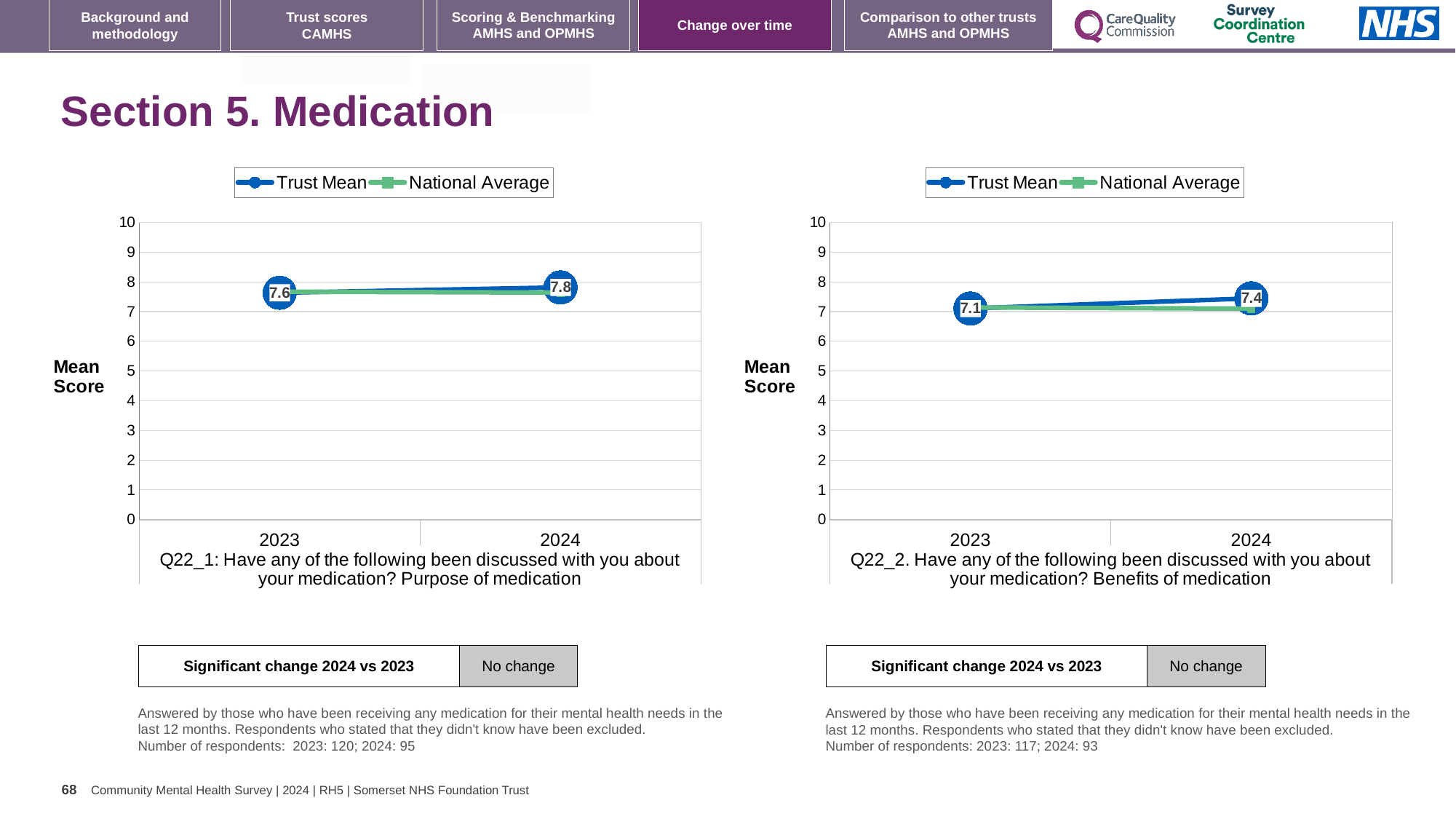
On the left chart (Q22_1: Purpose of medication), what is the Trust Mean for 2024? 7.8 On the right chart (Q22_2: Benefits of medication), what is the difference between the Trust Mean in 2024 and in 2023? 0.3 How many years are plotted on the x axis of the left chart (Q22_1: Purpose of medication)? 2 How many series does the legend of the right chart (Q22_2: Benefits of medication) list? 2 On the left chart (Q22_1: Purpose of medication), what is the Trust Mean for 2023? 7.6 On the right chart (Q22_2: Benefits of medication), what is the Trust Mean for 2023? 7.1 On the right chart (Q22_2: Benefits of medication), what is the Trust Mean for 2024? 7.4 On the left chart (Q22_1: Purpose of medication), by how much did the Trust Mean change from 2023 to 2024? 0.2 On the left chart (Q22_1: Purpose of medication), is the National Average for 2023 greater or less than 5? greater On the left chart (Q22_1: Purpose of medication), which year has the higher Trust Mean, 2023 or 2024? 2024 What kind of chart is the right chart (Q22_2: Benefits of medication)? line chart On the right chart (Q22_2: Benefits of medication), does the Trust Mean rise or fall from 2023 to 2024? rise